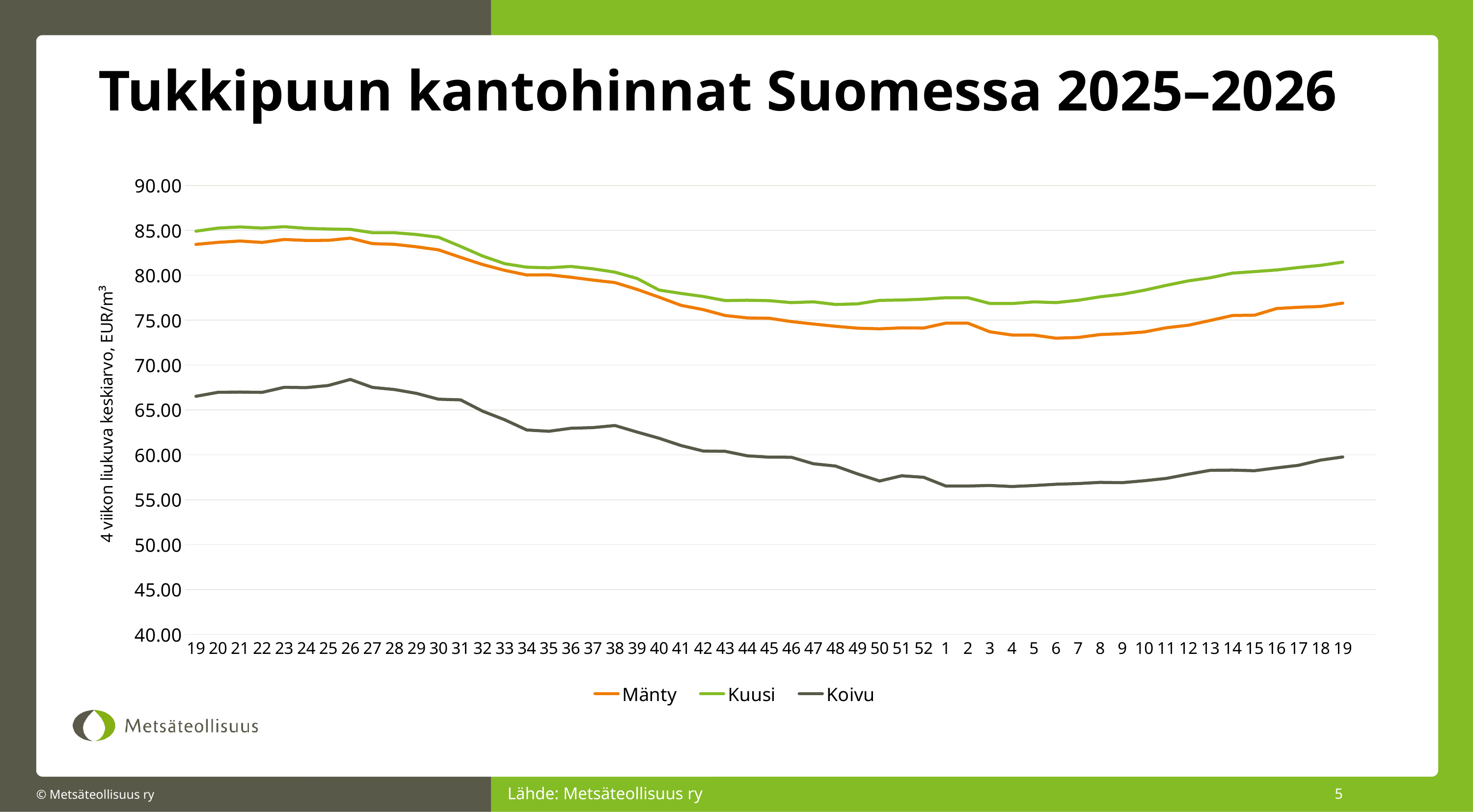
Is the value for Koivu at week 26 greater or less than 65.00? greater Is the value for Koivu at week 1 greater or less than 60.00? less What is the title of the chart? Tukkipuun kantohinnat Suomessa 2025–2026 Which series has the highest values throughout the chart? Kuusi Is the value for Kuusi at the last week (19) greater or less than 80.00? greater At week 40, which is larger, the value for Kuusi or the value for Mänty? Kuusi Does the Koivu line rise or fall from week 26 to week 1? fall Does the Mänty line rise or fall from week 6 to week 19 at the right end of the chart? rise What kind of chart is shown on the slide? line chart How many series does the legend list? 3 Which series has the lowest values throughout the chart? Koivu